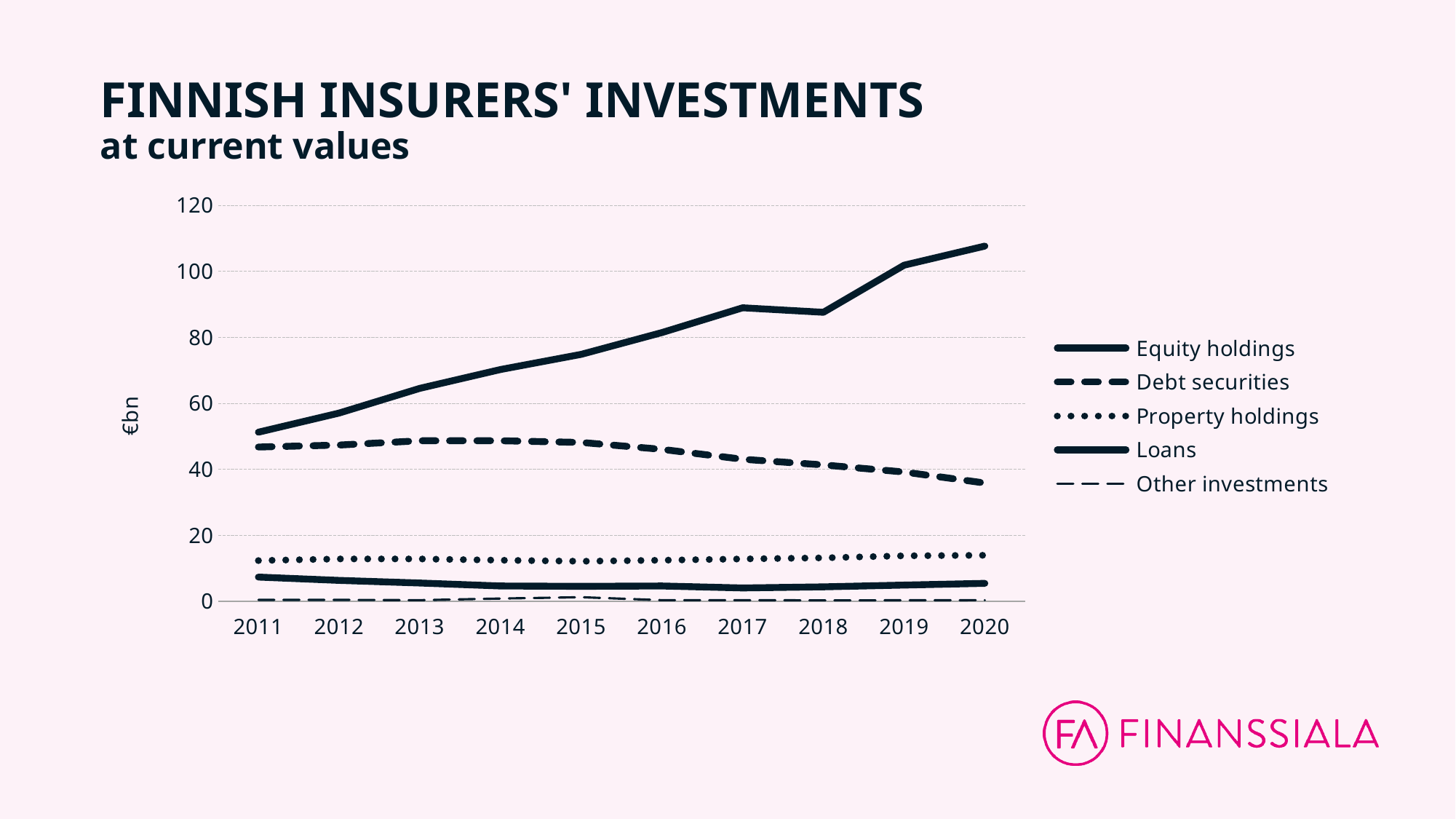
How many series does the legend list? 5 How many years are shown on the x axis? 10 Do the values for Equity holdings rise or fall from 2011 to 2020? rise Is the value for Equity holdings in 2011 greater or less than 60? less Which series has the highest value in 2020? Equity holdings Do the values for Debt securities rise or fall from 2015 to 2020? fall Is the value for Equity holdings in 2020 greater or less than 100? greater Which series has the lowest value in 2020? Other investments Is the value for Debt securities in 2020 greater or less than 40? less What kind of chart is shown on the slide? line chart In 2017, which is larger: Equity holdings or Debt securities? Equity holdings